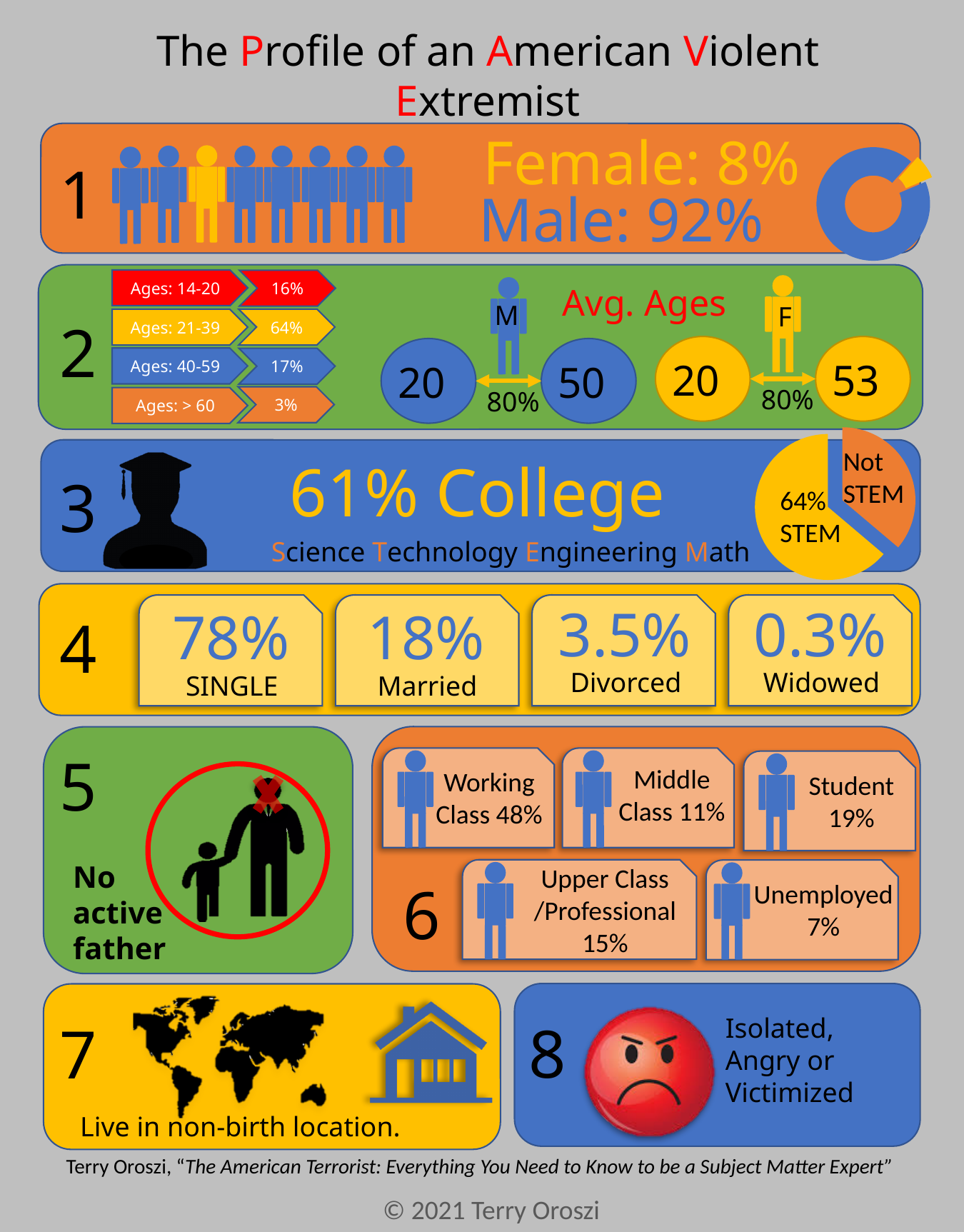
In the age breakdown in section 2, which age group has the lowest percentage? Ages: > 60 In the age breakdown in section 2, which age group has the highest percentage? Ages: 21-39 In the pie chart in section 3, which slice is larger, STEM or Not STEM? STEM How many slices does the pie chart in section 3 have? 2 In the gender donut chart in section 1, what percentage is Female? 8% In the gender donut chart in section 1, which group has the larger share, Male or Female? Male In the gender donut chart in section 1, what percentage is Male? 92% In the age breakdown in section 2, what is the difference in percentage points between Ages 21-39 and Ages 14-20? 48 percentage points In the gender donut chart in section 1, what is the difference in percentage points between Male and Female? 84 percentage points How many age groups are listed in the age breakdown in section 2? 4 What kind of chart is shown at the right of section 1 for the gender split? Donut (pie) chart In the pie chart in section 3, what percentage is STEM? 64%